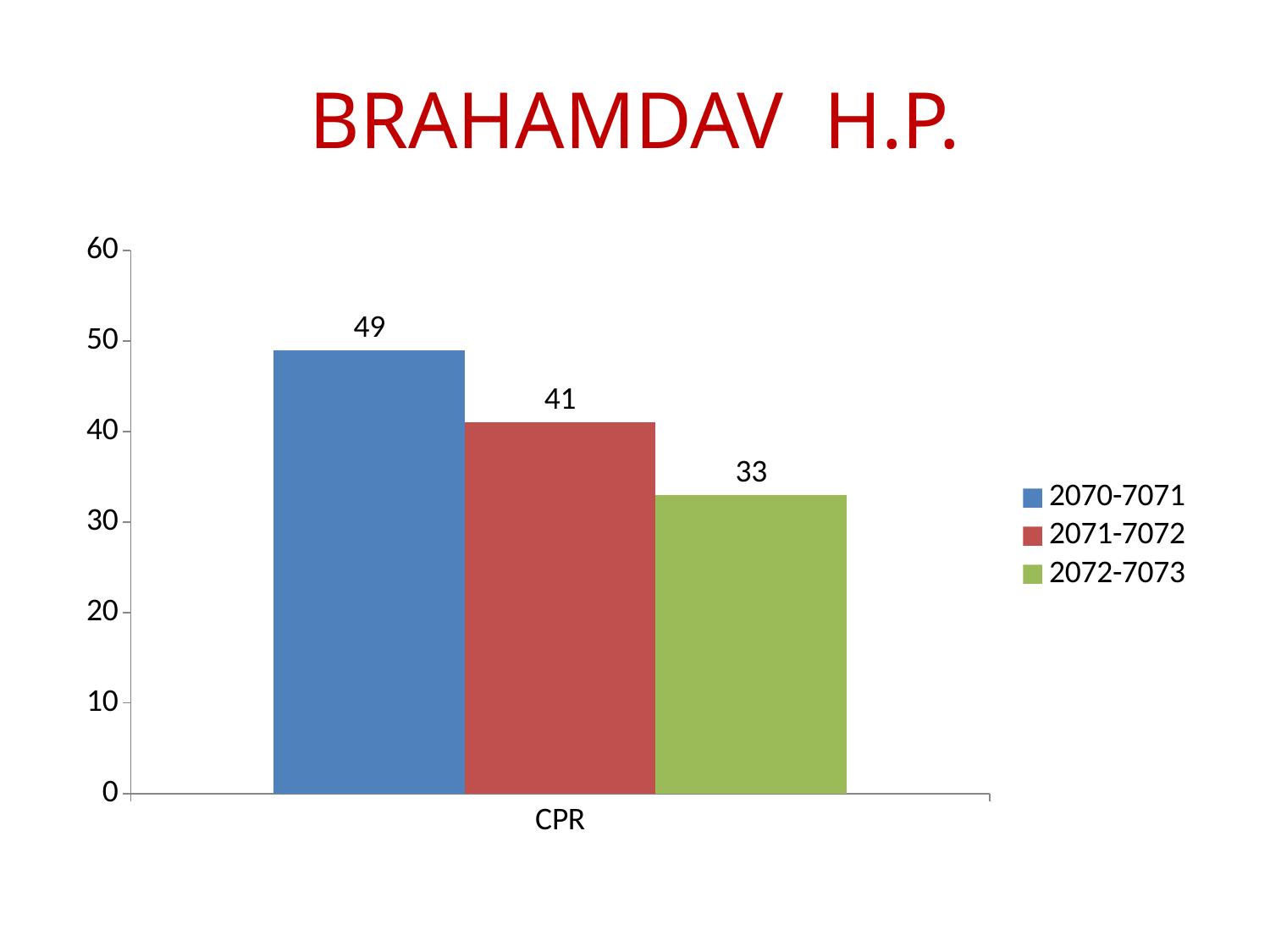
What is the difference between the CPR values for 2070-7071 and 2072-7073? 16 Is the CPR value for 2070-7071 greater or less than 40? greater Which is larger, the CPR value for 2071-7072 or for 2072-7073? 2071-7072 What is the CPR value for the 2071-7072 series? 41 What is the difference between the CPR values for 2071-7072 and 2072-7073? 8 What is the title of the slide? BRAHAMDAV H.P. What is the CPR value for the 2070-7071 series? 49 What kind of chart is shown on the slide? bar chart Which series has the highest CPR value? 2070-7071 How many series does the legend list? 3 What is the CPR value for the 2072-7073 series? 33 Which series has the lowest CPR value? 2072-7073